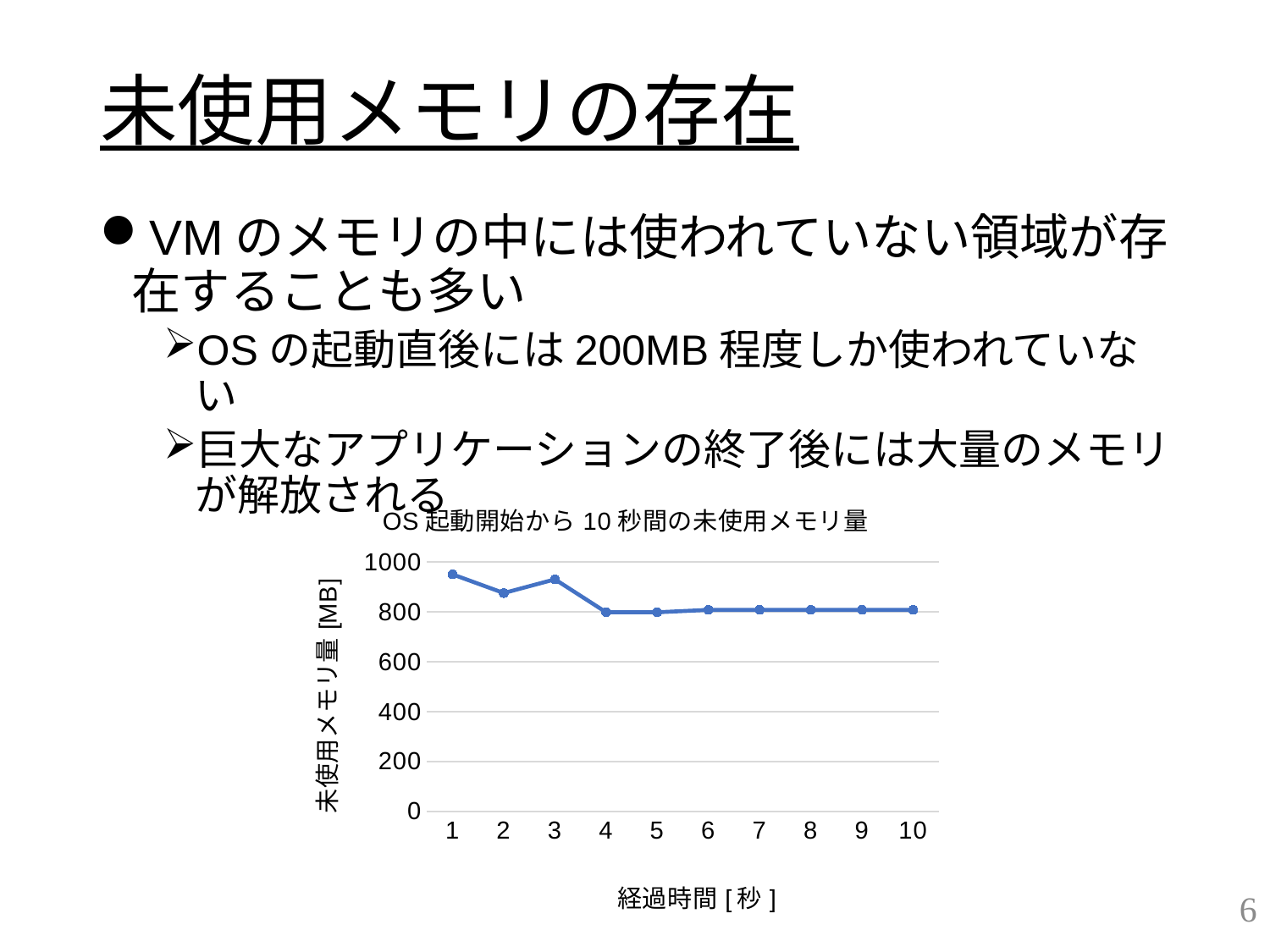
Is the value at elapsed time 1 greater or less than 1000? less Which is larger, the value at elapsed time 1 or at elapsed time 4? elapsed time 1 What kind of chart is shown on the slide? line chart What is the title of the chart? OS 起動開始から 10 秒間の未使用メモリ量 Is the value at elapsed time 2 greater or less than 800? greater Overall, do the values rise or fall from elapsed time 1 to elapsed time 10? fall Which is larger, the value at elapsed time 2 or at elapsed time 3? elapsed time 3 Is the value at elapsed time 10 greater or less than 1000? less How many data points are plotted on the chart? 10 What is the label of the y axis of the chart? 未使用メモリ量 [MB]